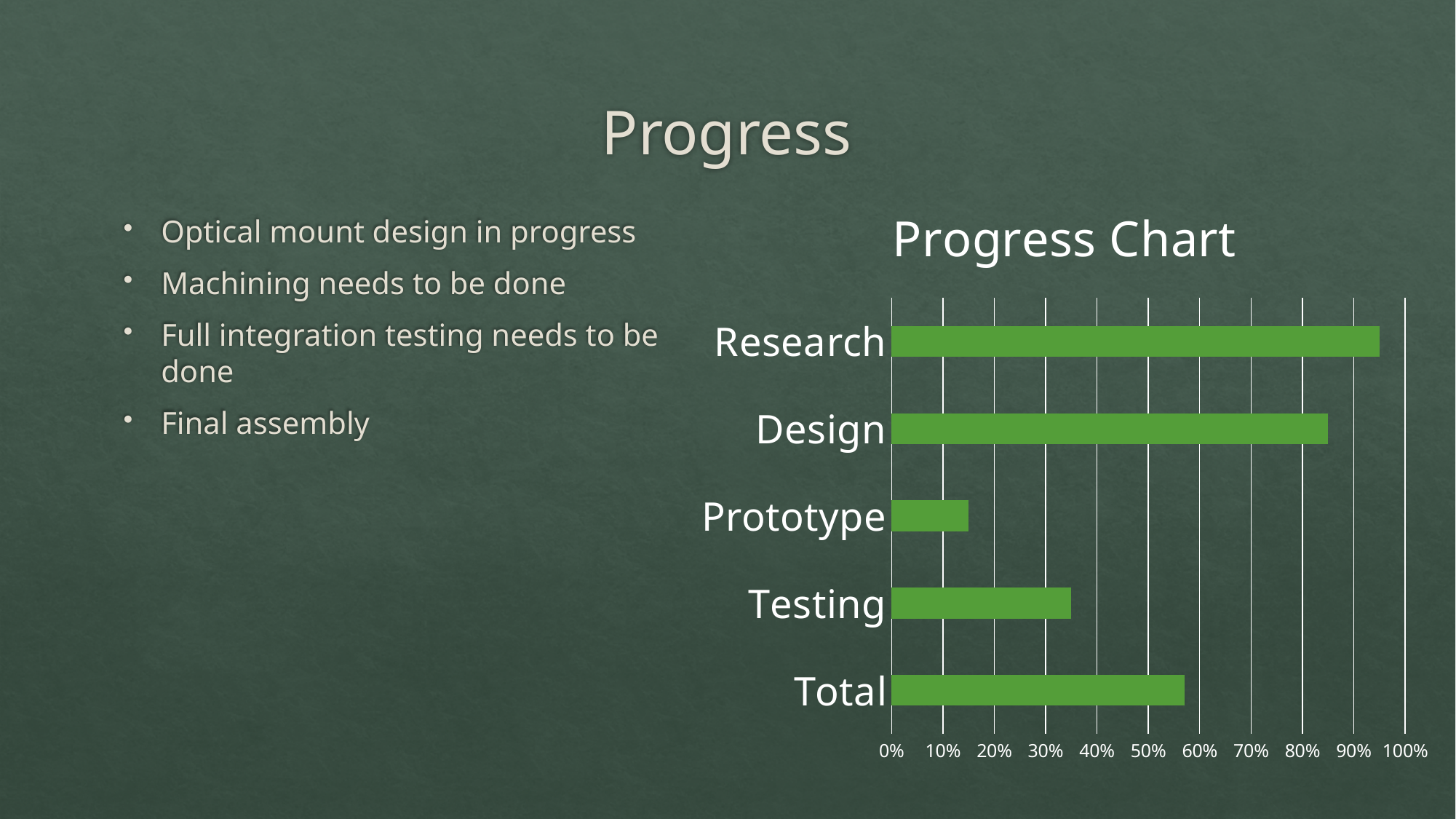
Is the value for Design greater or less than 80%? greater How many categories are plotted in the chart? 5 Is the value for Total greater or less than 50%? greater Is the value for Research greater or less than 90%? greater Which has a larger value, Testing or Prototype? Testing Which category has the highest value in the chart? Research What kind of chart is shown on the slide? bar chart Which category has the lowest value in the chart? Prototype What is the title of the chart? Progress Chart Which has a larger value, Design or Total? Design